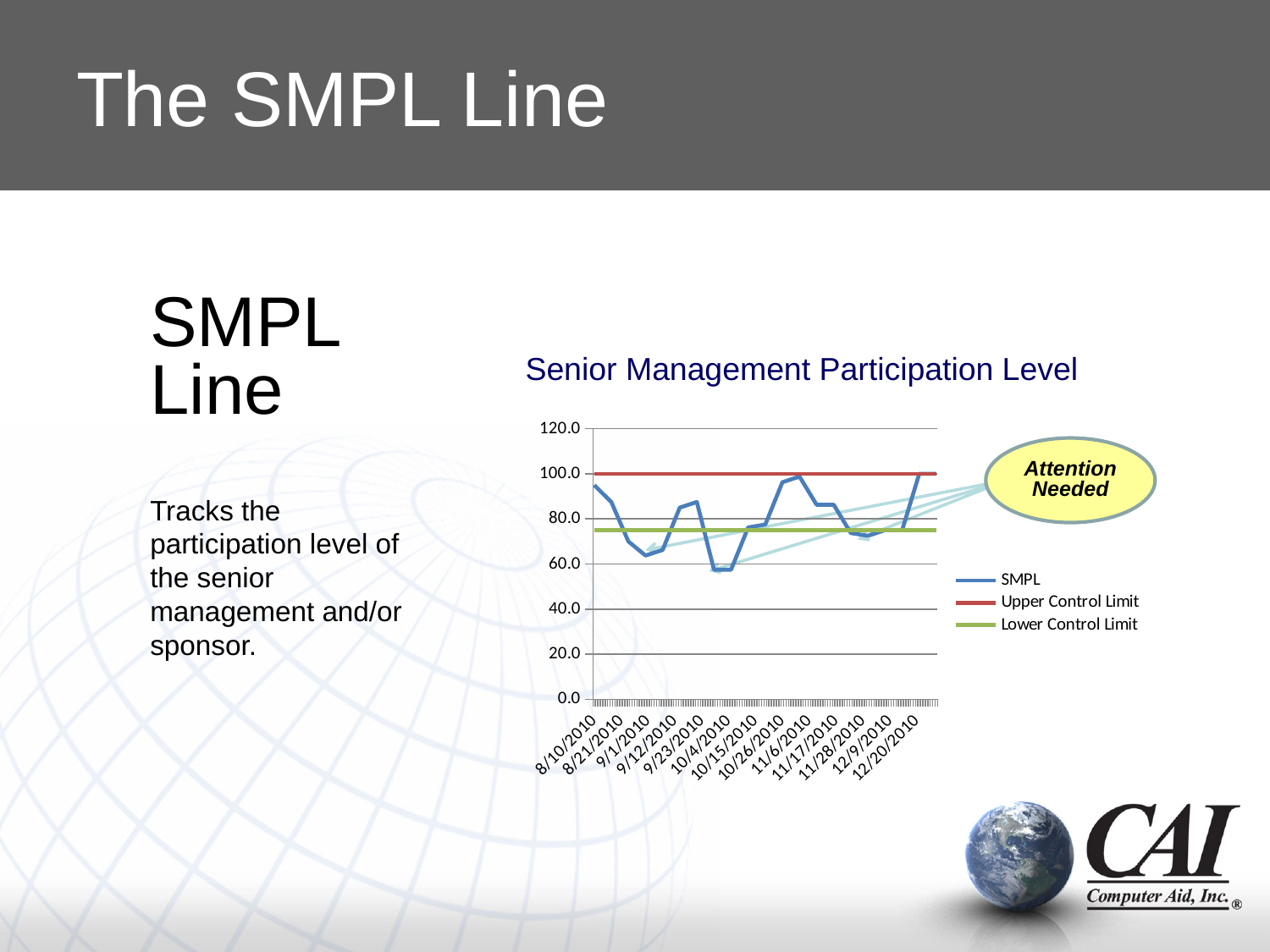
Which is higher, the Upper Control Limit or the Lower Control Limit? Upper Control Limit What text appears in the yellow callout next to the chart? Attention Needed What value does the Upper Control Limit line sit at? 100.0 Does the SMPL line rise or fall between 12/9/2010 and 12/20/2010? rise Is the Lower Control Limit greater or less than 60? greater Is the Upper Control Limit greater or less than 80? greater What is the title of the chart? Senior Management Participation Level What kind of chart is shown on the slide? line chart Is the lowest SMPL value on the chart greater or less than 80? less How many series does the chart legend list? 3 How many date labels are shown on the x axis? 13